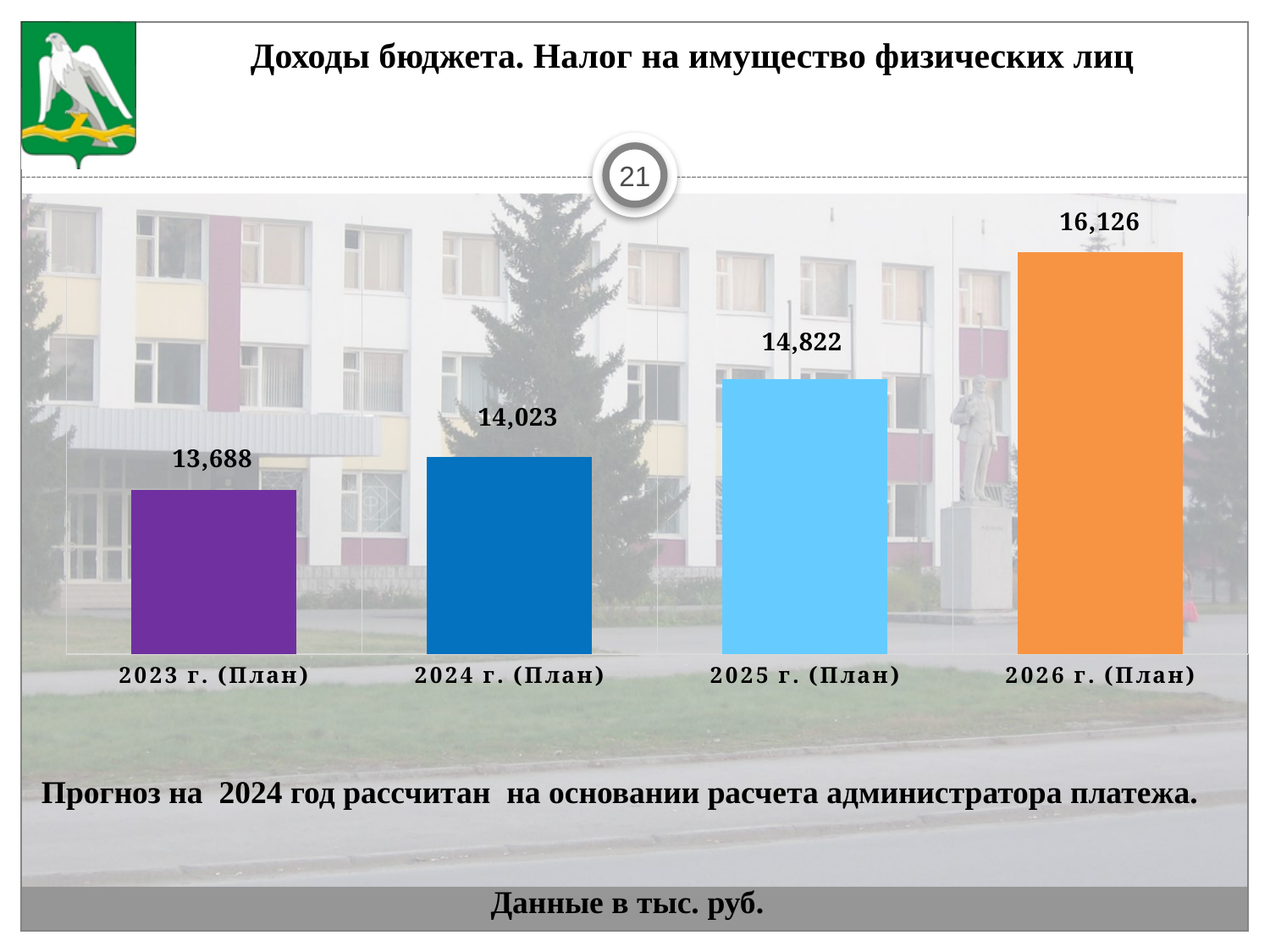
Which category has the highest value? 2026 г. (План) What is the value for 2025 г. (План)? 14,822 How many categories are shown in the chart? 4 What kind of chart is shown on the slide? bar chart Which category has the lowest value? 2023 г. (План) What is the difference between the values for 2025 г. (План) and 2024 г. (План)? 799 What is the value for 2026 г. (План)? 16,126 What is the value for 2024 г. (План)? 14,023 Which is larger, the value for 2024 г. (План) or 2025 г. (План)? 2025 г. (План) Do the values rise or fall from 2023 г. (План) to 2026 г. (План)? rise What is the difference between the values for 2026 г. (План) and 2023 г. (План)? 2,438 What is the value for 2023 г. (План)? 13,688